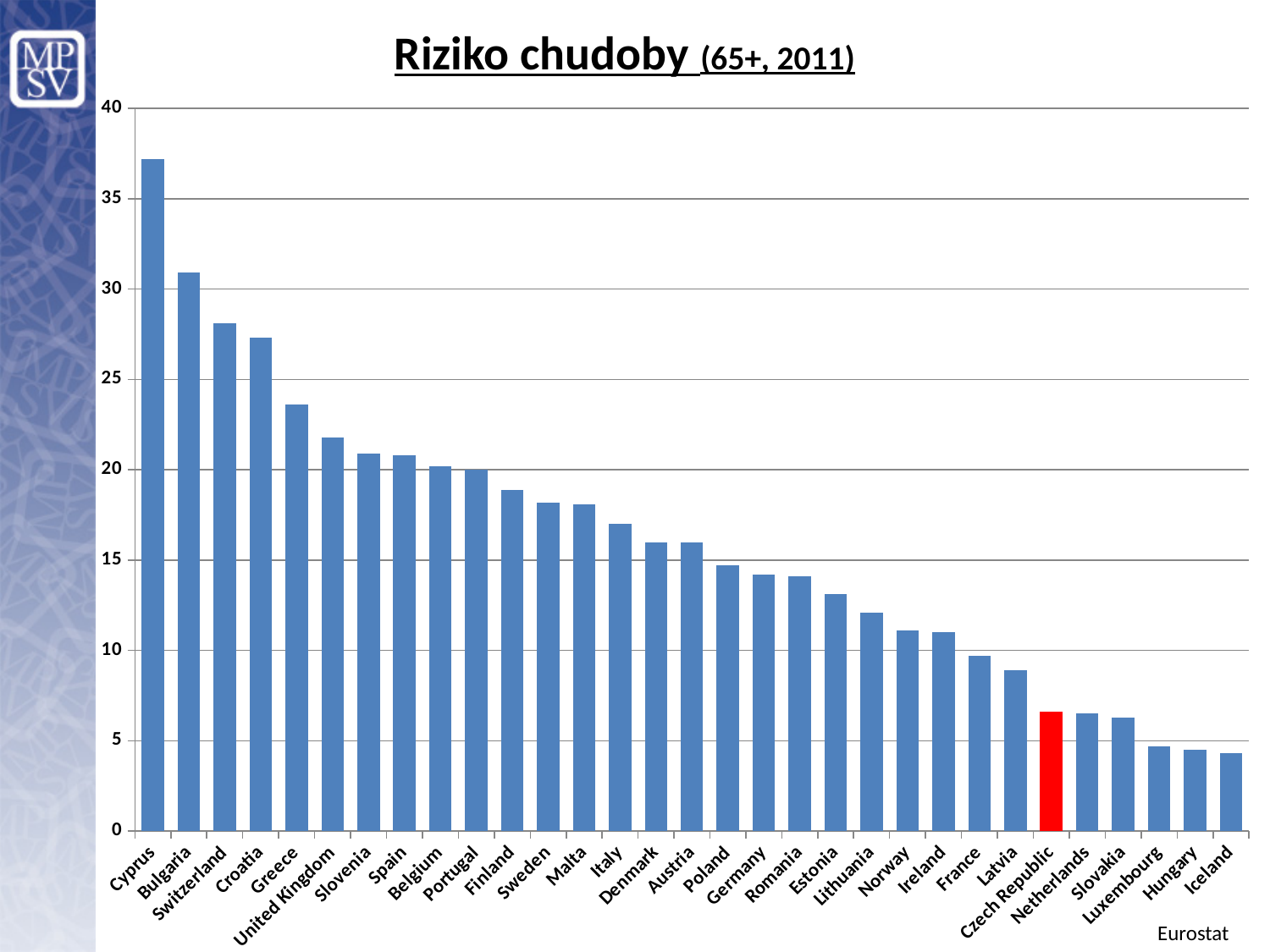
Is the value for Czech Republic greater or less than 5? greater How many countries are shown on the x axis of the chart? 31 Is the value for Latvia greater or less than 10? less Which has the larger value, Greece or United Kingdom? Greece Is the value for Greece greater or less than 25? less Do the values rise or fall from left to right along the x axis? fall What kind of chart is shown on the slide? bar chart Which country's bar is coloured red in the chart? Czech Republic Which country has the highest value in the chart? Cyprus